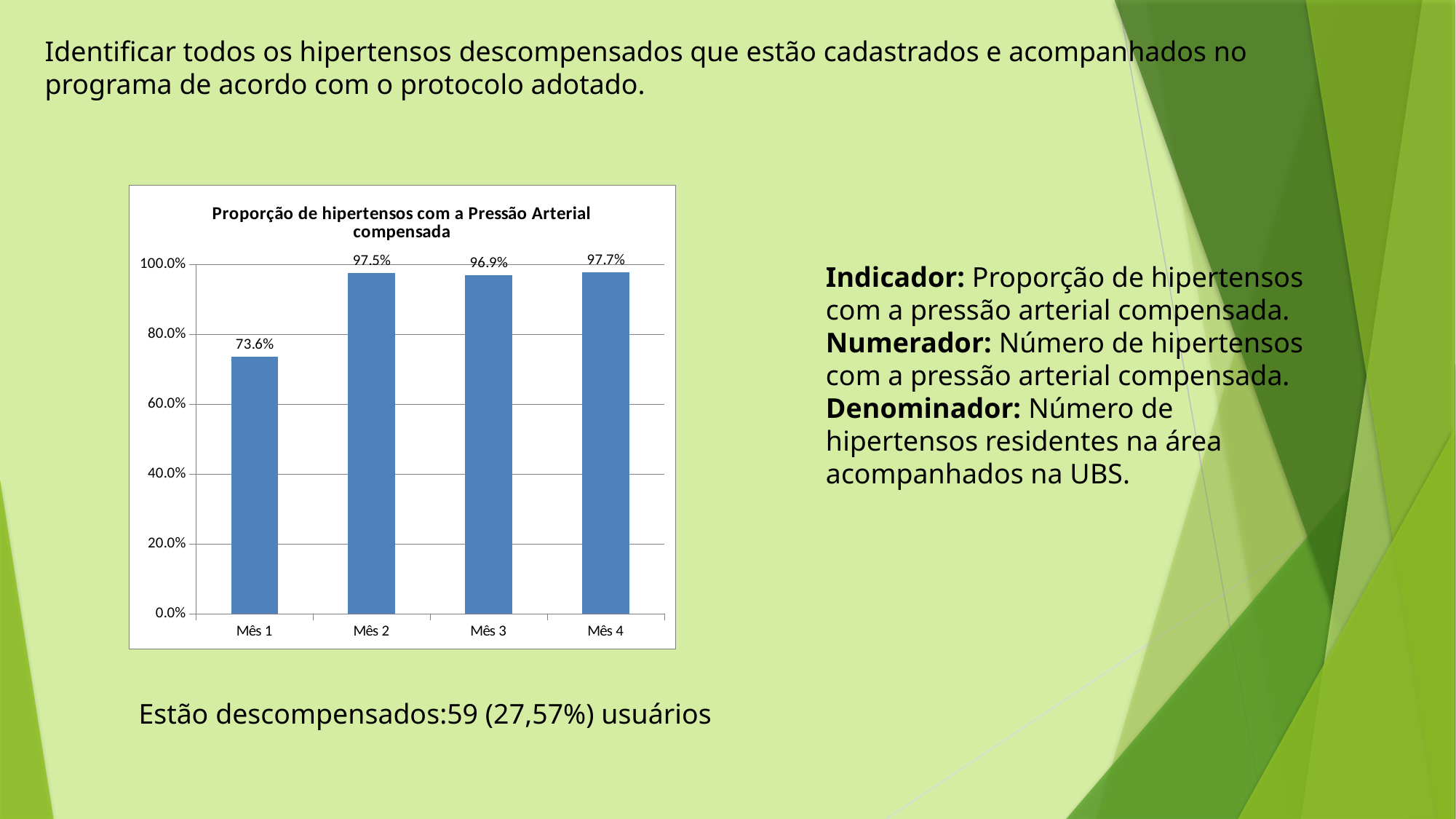
Does the value rise or fall from Mês 1 to Mês 2? rise What is the value for Mês 2? 97.5% What is the value for Mês 3? 96.9% What is the difference between the values for Mês 2 and Mês 1? 23.9% Is the value for Mês 1 greater or less than 80.0%? less What is the value for Mês 1? 73.6% What is the value for Mês 4? 97.7% What is the title of the chart? Proporção de hipertensos com a Pressão Arterial compensada Which is larger, the value for Mês 1 or the value for Mês 3? Mês 3 Which month has the lowest proportion? Mês 1 What kind of chart is shown? bar chart How many months are shown on the x axis? 4